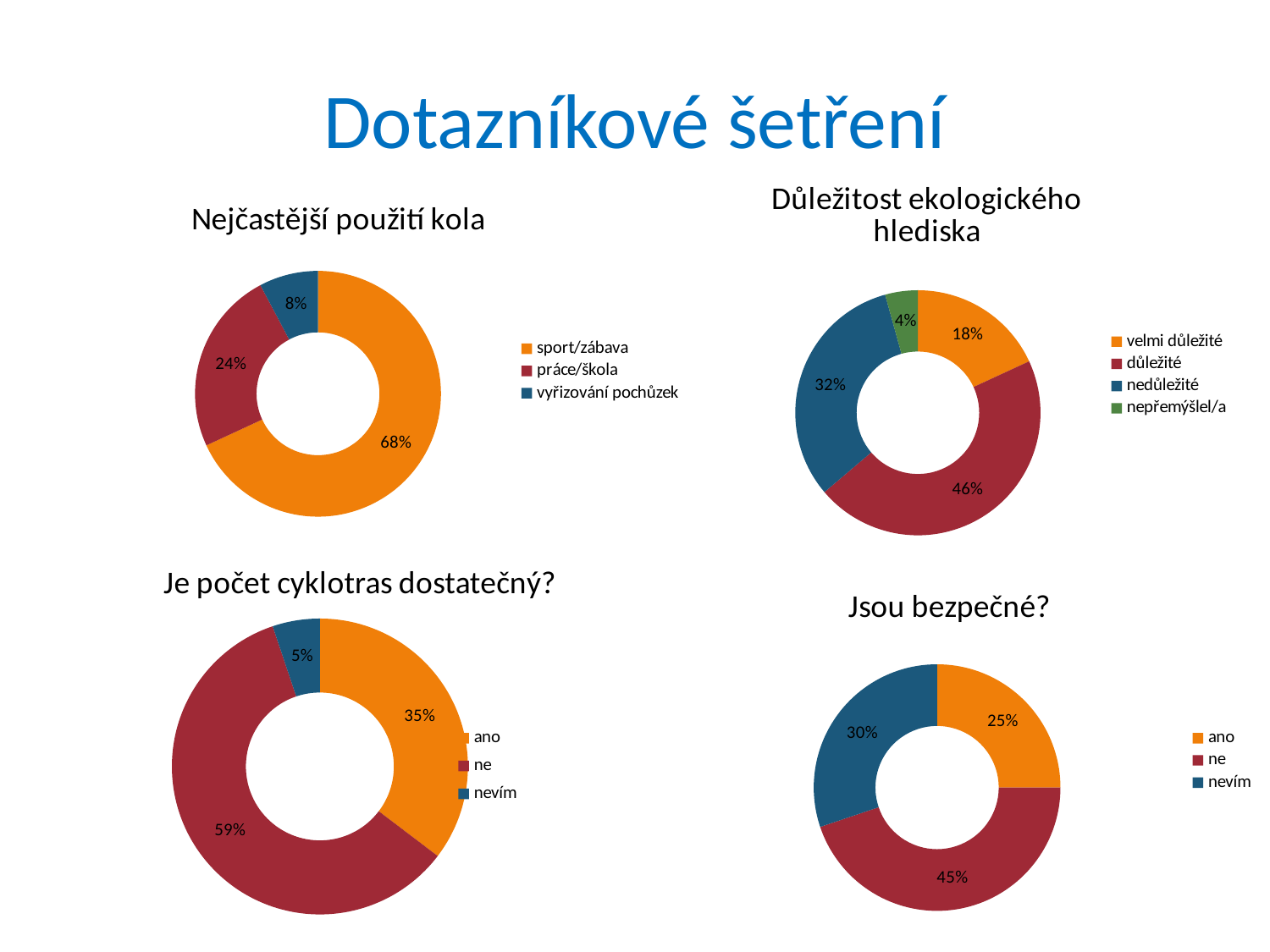
In the chart titled "Jsou bezpečné?", what percentage answered nevím? 30% In the chart titled "Důležitost ekologického hlediska", what percentage is shown for nedůležité? 32% In the chart titled "Je počet cyklotras dostatečný?", which is larger, ano or nevím? ano What type of chart is used for "Jsou bezpečné?"? Doughnut (pie) chart In the chart titled "Důležitost ekologického hlediska", which category has the largest share? důležité In the chart titled "Je počet cyklotras dostatečný?", what percentage answered ne? 59% In the chart titled "Nejčastější použití kola", which category has the smallest share? vyřizování pochůzek In the chart titled "Důležitost ekologického hlediska", what is the difference between the shares for důležité and velmi důležité? 28% In the chart titled "Důležitost ekologického hlediska", how many categories does the legend list? 4 How many charts are shown on the slide? 4 In the chart titled "Nejčastější použití kola", what percentage is shown for sport/zábava? 68% In the chart titled "Jsou bezpečné?", what is the difference between the shares for ne and ano? 20%